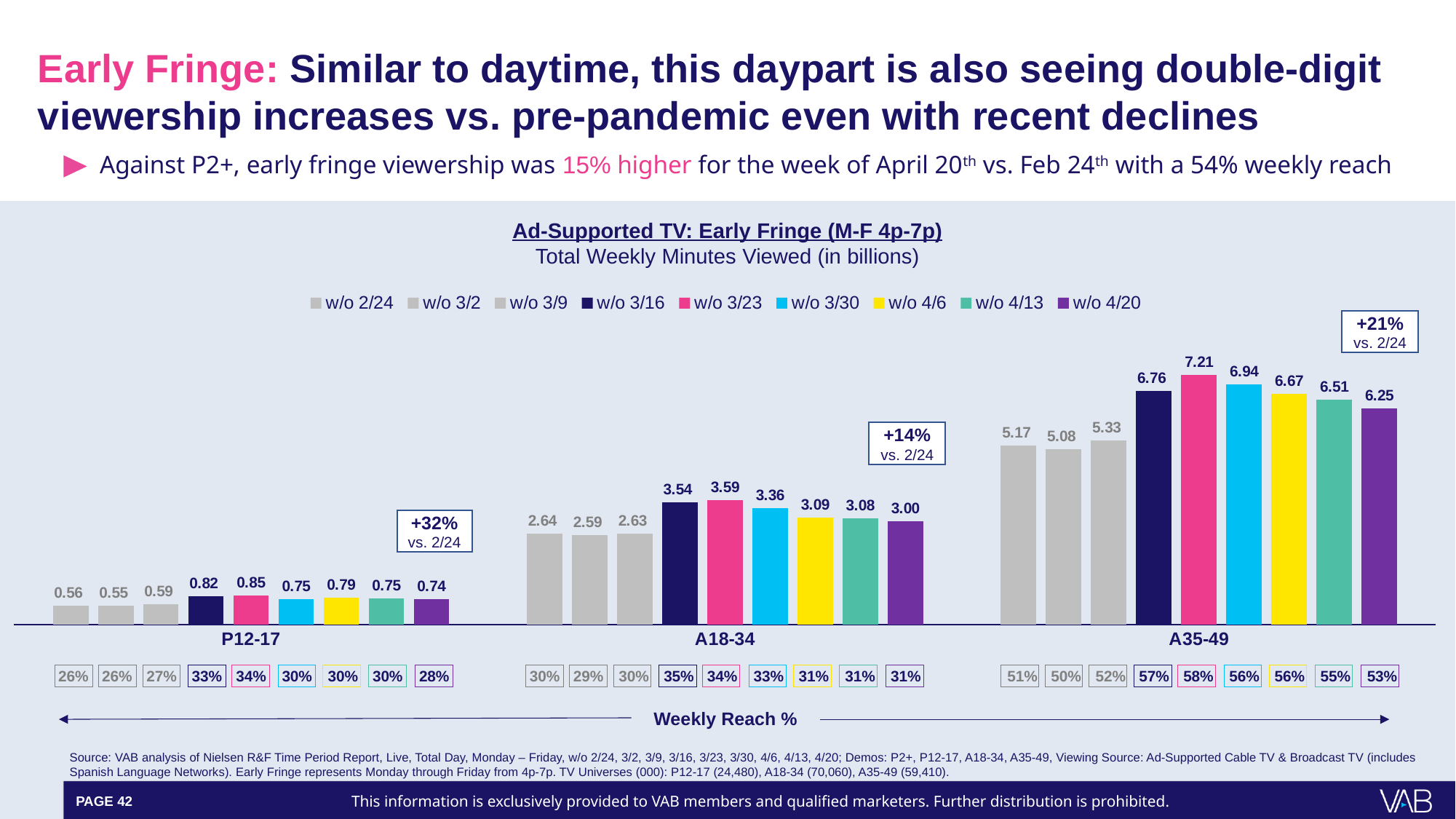
Which week has the highest value for A18-34? w/o 3/23 What is the difference between the w/o 3/23 and w/o 4/20 values for A35-49? 0.96 What kind of chart is this? bar chart How many series does the legend list? 9 Which is larger for A18-34: the w/o 3/16 value or the w/o 3/30 value? w/o 3/16 Which week has the lowest value for P12-17? w/o 3/2 What percentage change vs. 2/24 is annotated for A35-49? +21% What is the value for A35-49 in the w/o 3/23 series? 7.21 What is the weekly reach % for A35-49 in the w/o 3/23 series? 58% What is the value for A18-34 in the w/o 4/20 series? 3.00 What is the value for P12-17 in the w/o 2/24 series? 0.56 How many demographic categories are shown on the x axis? 3